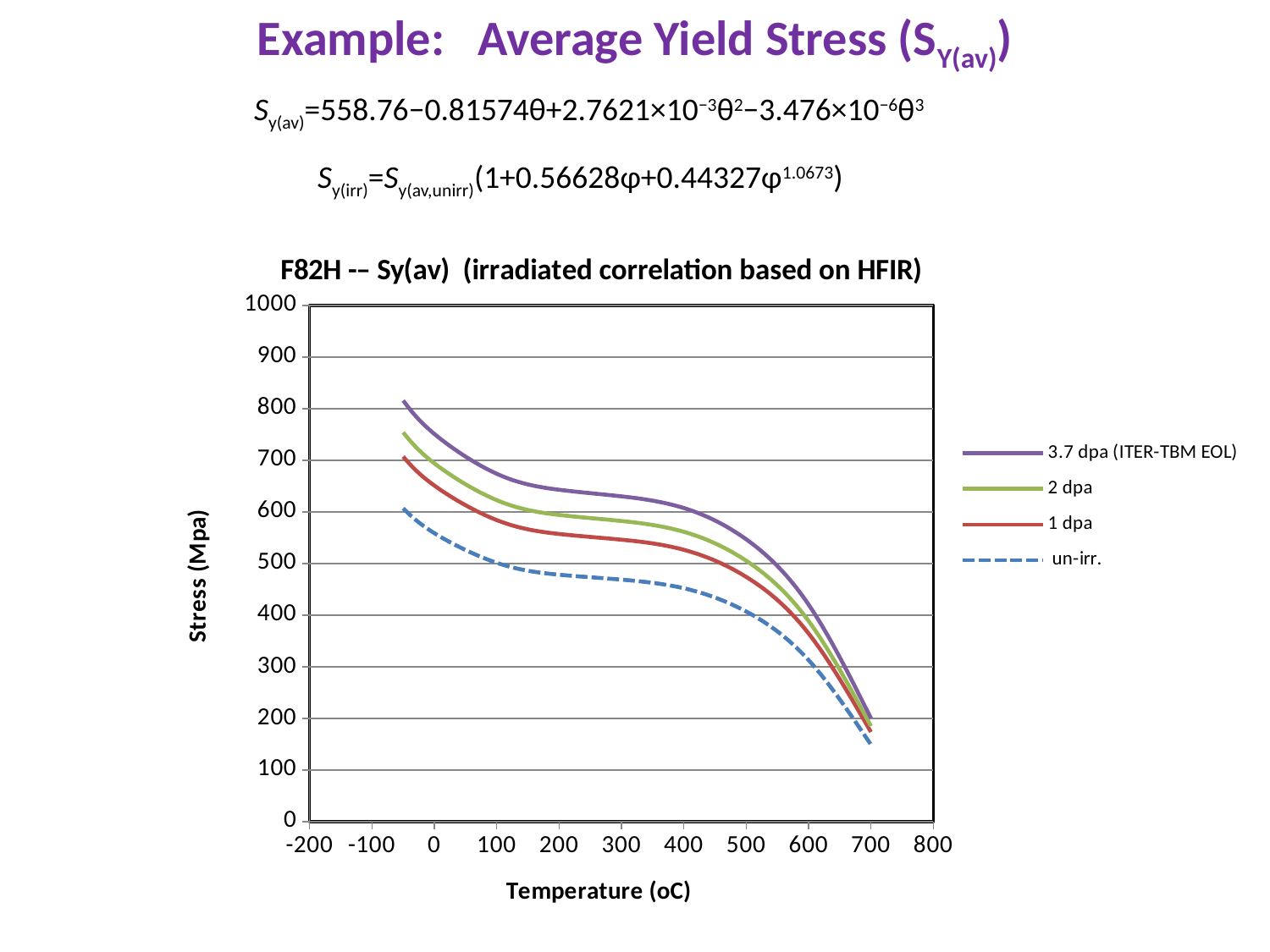
Is the value for the 2 dpa series at 700 °C greater or less than 300? less What kind of chart is shown on the slide? line chart What is the label of the vertical axis? Stress (Mpa) How many series does the legend list? 4 Is the value for the 3.7 dpa (ITER-TBM EOL) series at 0 °C greater or less than 700? greater Do the stress values rise or fall as temperature increases from -50 °C to 700 °C? fall What is the title of the chart? F82H -- Sy(av) (irradiated correlation based on HFIR) Which series is drawn with a dashed line? un-irr. Is the value for the un-irr. series at 300 °C greater or less than 500? less At 300 °C, which series has the larger value: 3.7 dpa (ITER-TBM EOL) or un-irr.? 3.7 dpa (ITER-TBM EOL) Which series has the highest stress values across the temperature range? 3.7 dpa (ITER-TBM EOL)